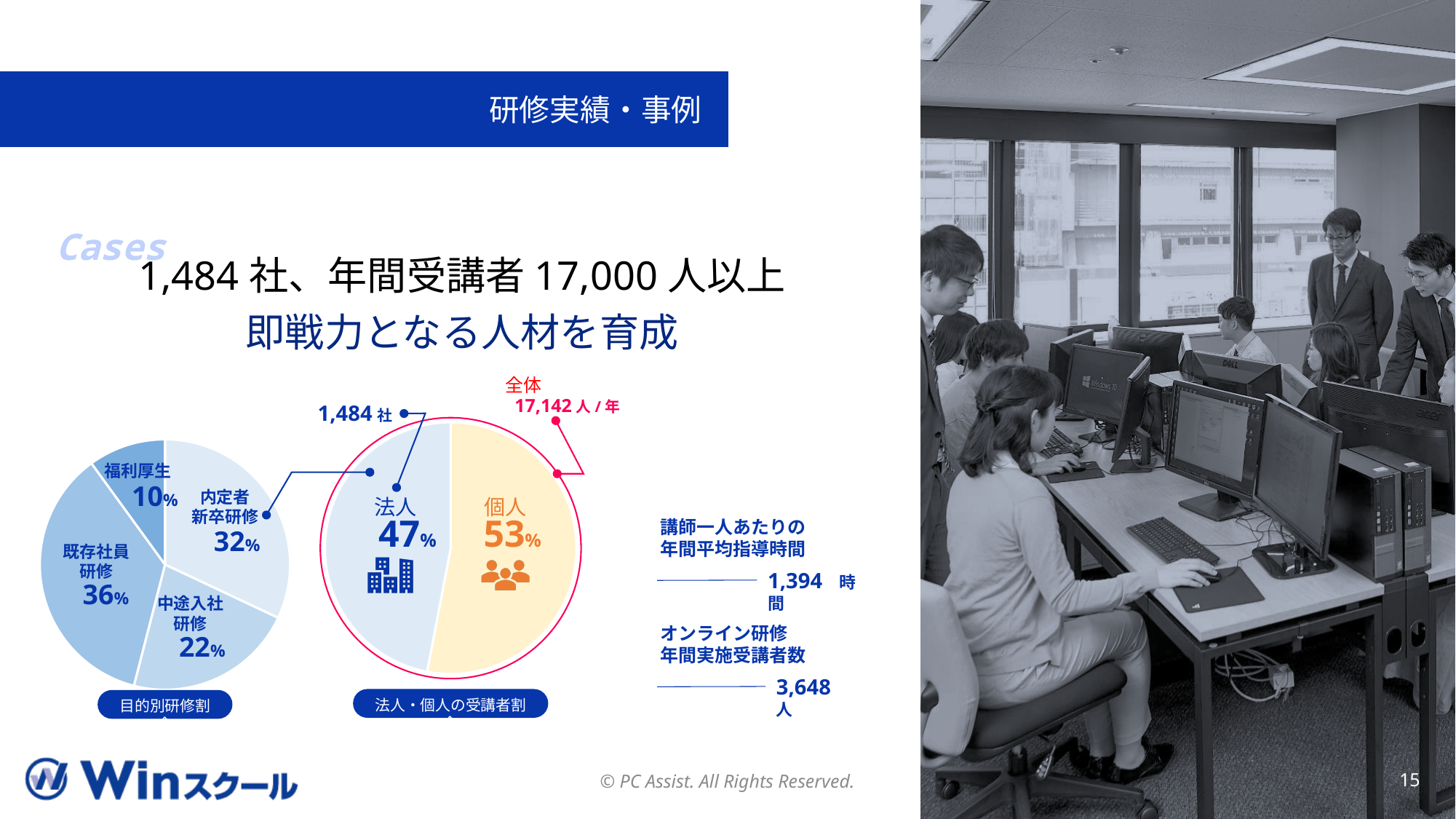
In the 目的別研修割 pie chart, what share is 既存社員研修? 36% In the 目的別研修割 pie chart, how many categories are shown? 4 In the 目的別研修割 pie chart, what share is 中途入社研修? 22% In the 法人・個人の受講者割 pie chart, what share is 個人? 53% In the 法人・個人の受講者割 pie chart, what share is 法人? 47% What kind of chart is the 法人・個人の受講者割 chart? Pie chart In the 法人・個人の受講者割 pie chart, which is larger, 法人 or 個人? 個人 In the 目的別研修割 pie chart, what is the difference between 内定者新卒研修 and 中途入社研修? 10% In the 目的別研修割 pie chart, which category has the smallest share? 福利厚生 In the 目的別研修割 pie chart, which category has the largest share? 既存社員研修 In the 目的別研修割 pie chart, what share is 福利厚生? 10% What total number of participants per year is labelled above the 法人・個人の受講者割 pie chart? 17,142 人 / 年